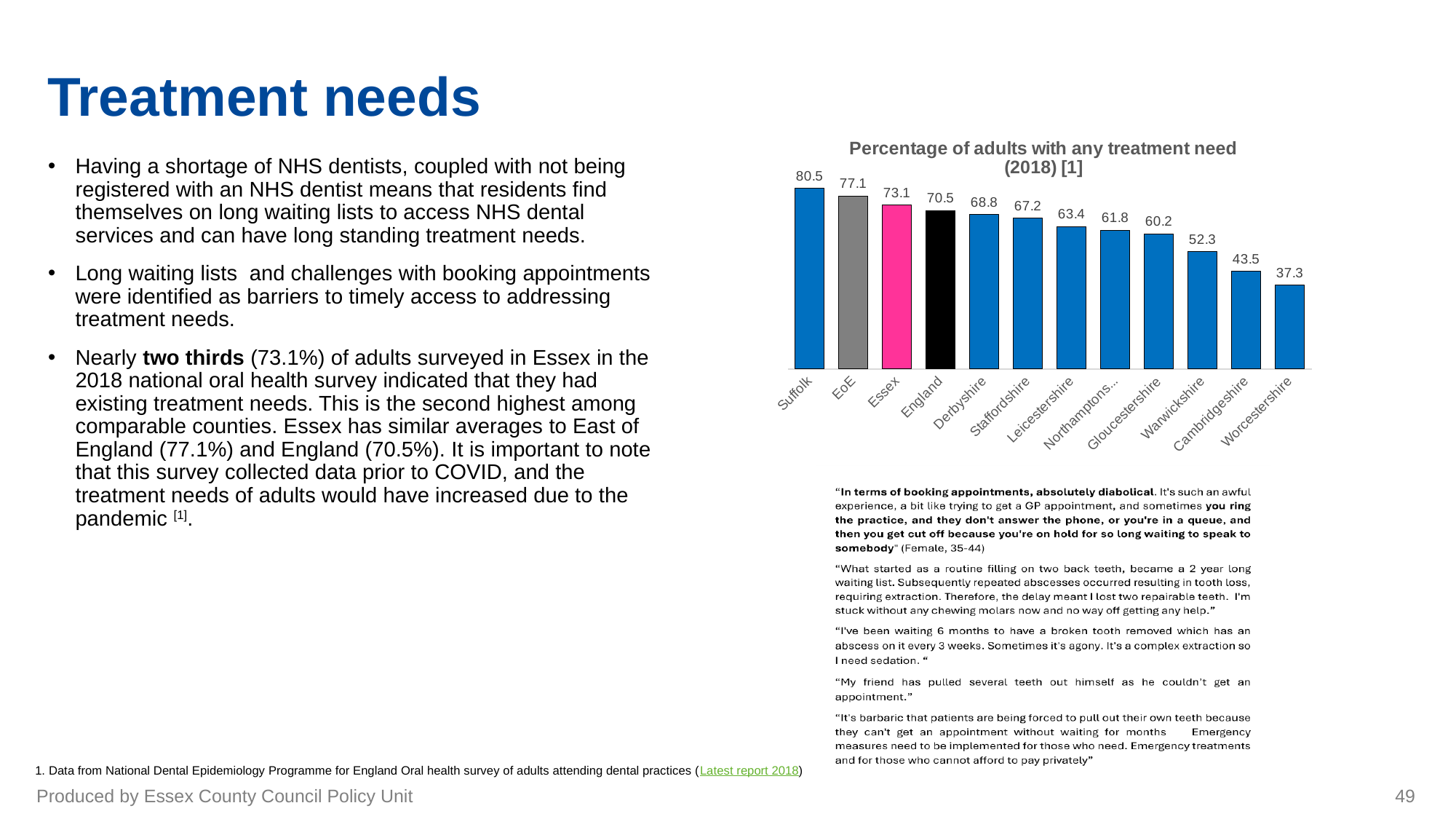
What is the difference between the values for Suffolk and Worcestershire? 43.2 What is the value for Essex in the chart? 73.1 Do the values rise or fall from left to right along the x axis? Fall Which category has the lowest value in the chart? Worcestershire What is the title of the chart? Percentage of adults with any treatment need (2018) [1] What is the difference between the values for EoE and Essex? 4 What is the value for England in the chart? 70.5 What colour is the bar for Essex? Pink Which is larger, the value for Derbyshire or the value for Warwickshire? Derbyshire What kind of chart is shown on the slide? Bar chart Which category has the highest value in the chart? Suffolk How many categories are shown in the chart? 12